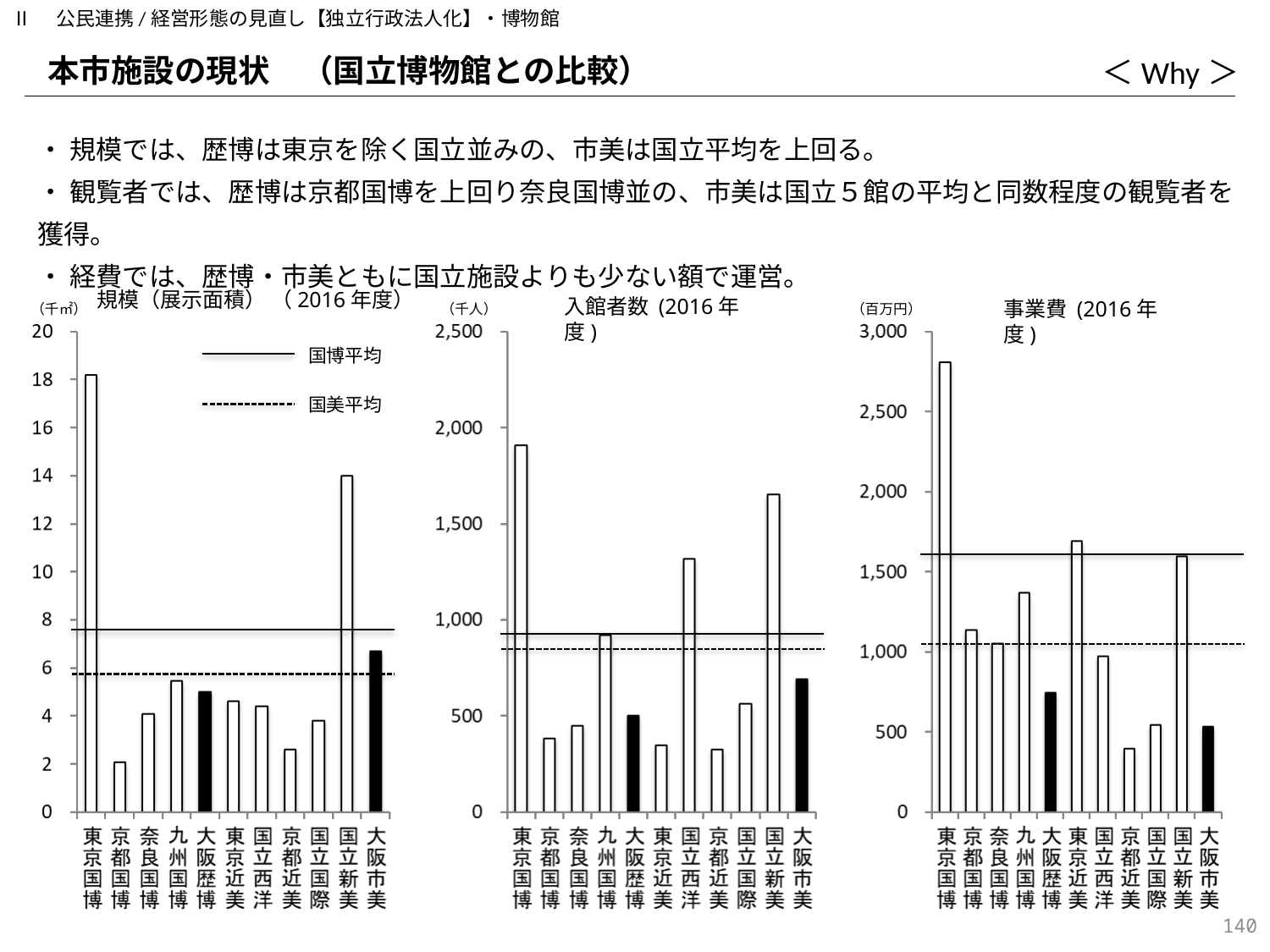
On the 規模（展示面積） chart, what does the dashed horizontal line represent according to the legend? 国美平均 On the 規模（展示面積） chart, which facility has the lowest value? 京都国博 On the 入館者数 chart, is the value for 大阪市美 greater or less than 500? greater On the 規模（展示面積） chart, which facility has the highest value? 東京国博 On the 入館者数 chart, is the value for 国立新美 greater or less than 1,500? greater On the 事業費 chart, which facility has the highest value? 東京国博 On the 事業費 chart, which is larger, the value for 大阪歴博 or the value for 大阪市美? 大阪歴博 On the 規模（展示面積） chart, which is larger, the value for 大阪歴博 or the value for 大阪市美? 大阪市美 On the 規模（展示面積） chart, is the value for 東京国博 greater or less than 16? greater What kind of chart is the 規模（展示面積） chart on the left? bar chart How many facilities (categories) are shown on the 入館者数 chart in the middle? 11 On the 入館者数 chart, which facility has the highest value? 東京国博